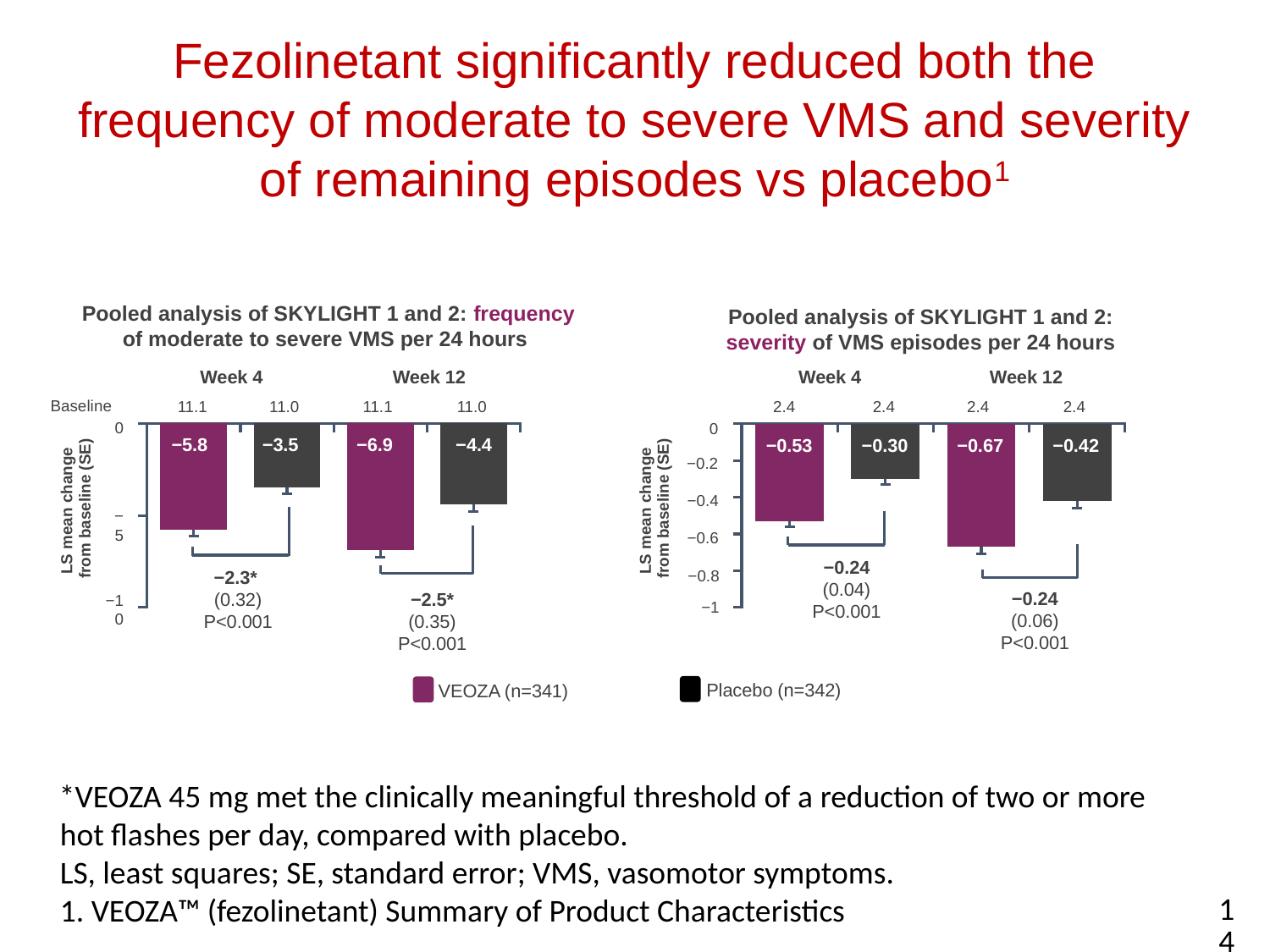
In the frequency chart (left), what is the difference between the VEOZA and Placebo values at Week 4? −2.3 In the severity chart (right), what is the LS mean change from baseline for Placebo at Week 4? −0.30 What is the baseline value shown above the bars in the severity chart (right)? 2.4 In the frequency chart (left), which bar shows the largest reduction from baseline? VEOZA at Week 12 What type of chart is used in the severity chart (right)? Bar chart In the severity chart (right), which bar shows the smallest reduction from baseline? Placebo at Week 4 In the severity chart (right), what is the difference between the VEOZA and Placebo values at Week 12? −0.25 In the severity chart (right), what is the LS mean change from baseline for VEOZA at Week 12? −0.67 In the frequency chart (left), which has the larger reduction at Week 12, VEOZA or Placebo? VEOZA In the frequency chart (left), what is the LS mean change from baseline for VEOZA at Week 4? −5.8 How many series does the legend list for the charts? 2 In the frequency chart (left), what is the LS mean change from baseline for Placebo at Week 12? −4.4